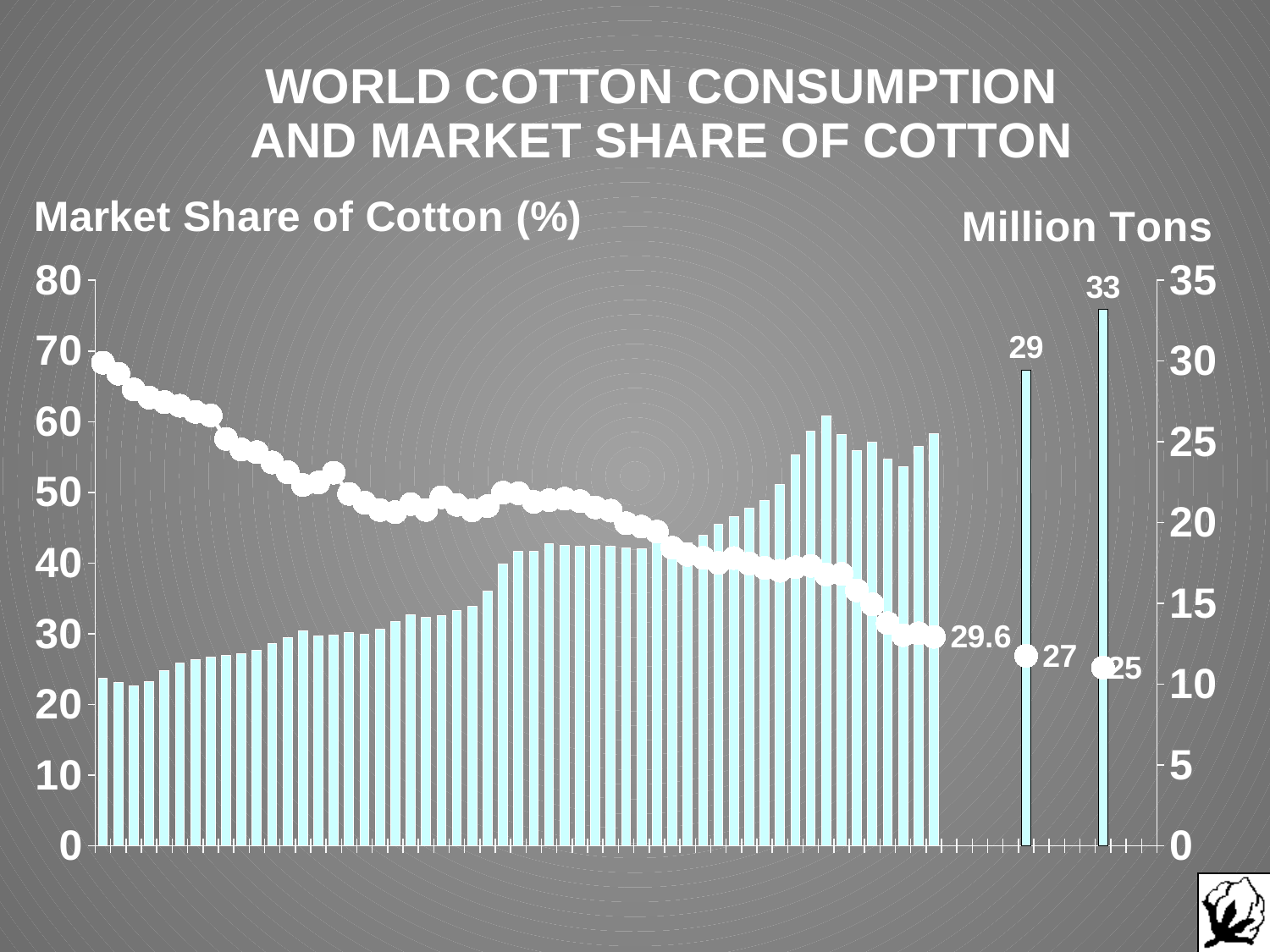
What is the difference between the two labeled bars on the right, 33 and 29? 4 What is the difference between the two isolated market share points labeled 27 and 25? 2 Is the first market share point on the left greater or less than 60? greater What is the label of the left vertical axis? Market Share of Cotton (%) What value is printed at the end of the continuous market share line? 29.6 What kind of chart is shown on the slide? Combined bar and line chart What value is printed on the second-to-last isolated bar on the right side of the chart? 29 Does the market share of cotton line generally rise or fall from left to right? Fall What is the title of the chart? WORLD COTTON CONSUMPTION AND MARKET SHARE OF COTTON What value is printed on the tallest bar at the right of the chart? 33 Which of the two labeled bars on the right is taller, the one labeled 29 or the one labeled 33? 33 What are the values printed on the two isolated market share points on the right side of the chart? 27 and 25